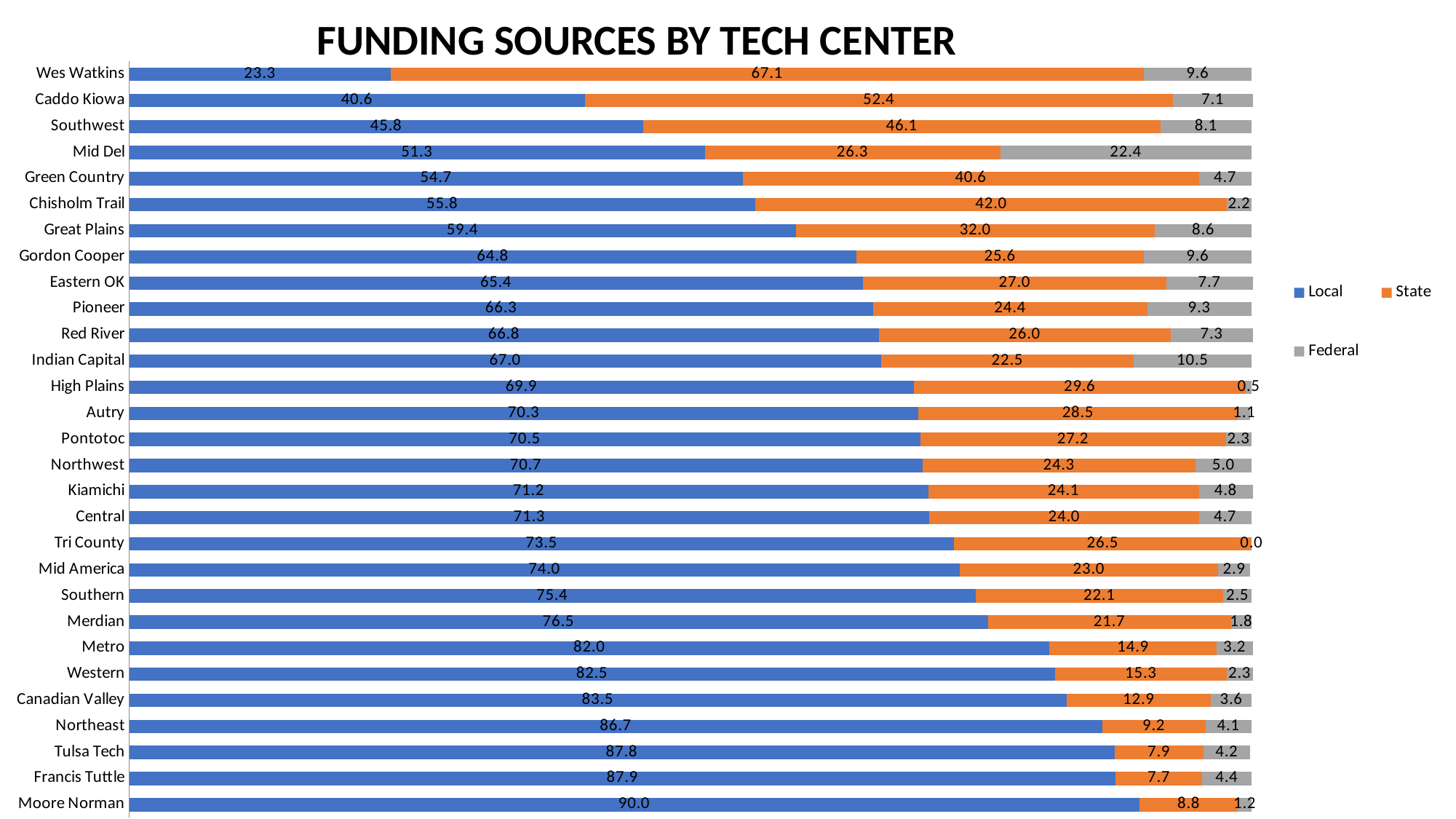
Which is larger, the State value for Caddo Kiowa or the State value for Southwest? Caddo Kiowa How many series does the legend list? 3 Which tech center has the lowest Local funding value? Wes Watkins Which tech center has the highest Federal funding value? Mid Del How many tech centers are shown on the chart? 29 What is the State funding value for Wes Watkins? 67.1 What is the title of the chart? FUNDING SOURCES BY TECH CENTER What kind of chart is this? Stacked bar chart What is the Federal funding value for Indian Capital? 10.5 What is the difference between the Local and State values for Mid Del? 25.0 Which tech center has the highest Local funding value? Moore Norman What is the Local funding value for Mid Del? 51.3